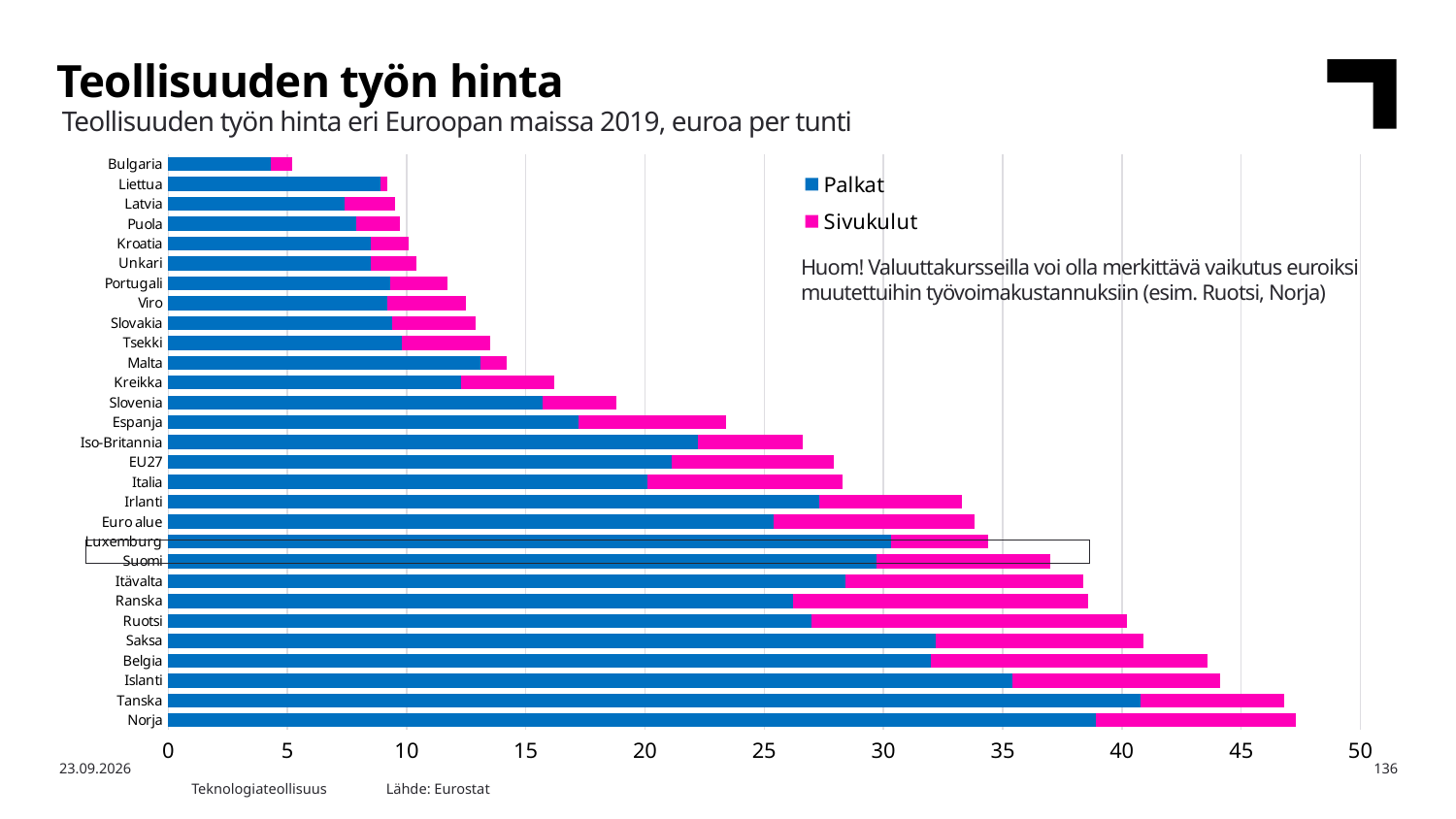
How many series does the legend list? 2 Is the total value for Suomi greater or less than 35? greater What kind of chart is shown on the slide? Stacked bar chart Is the total value for Norja greater or less than 45? greater Which has the larger total bar, Irlanti or Italia? Irlanti Do the total bars get longer or shorter going from the top of the chart to the bottom? Longer How many countries or regions are shown on the chart? 29 Is the total value for Bulgaria greater or less than 10? less Which country has the longest total bar? Norja Which legend entry is shown in pink? Sivukulut Which country has the shortest total bar? Bulgaria